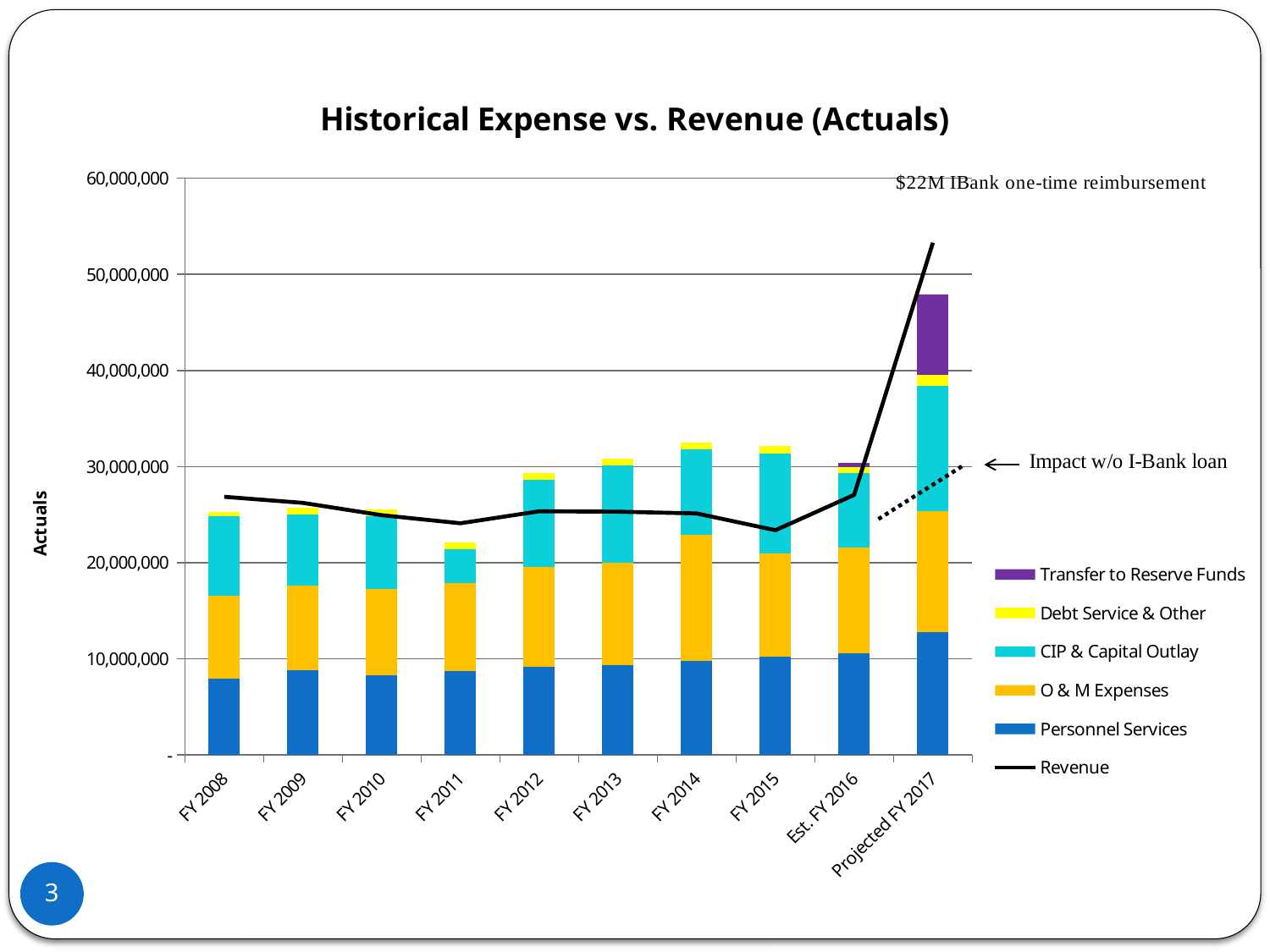
Which series is shown in purple at the top of the Projected FY 2017 bar? Transfer to Reserve Funds How many series does the legend list? 6 Is the Revenue value for Projected FY 2017 greater or less than 50,000,000? greater What kind of chart is shown on the slide? combination bar and line chart Which fiscal year has the tallest stacked expense bar? Projected FY 2017 Is the Personnel Services segment for FY 2008 greater or less than 10,000,000? less Which fiscal year has the shortest stacked expense bar? FY 2011 Which has the larger total expense bar, FY 2008 or FY 2014? FY 2014 Is the total expense bar for Projected FY 2017 greater or less than 40,000,000? greater Does the Revenue line rise or fall from Est. FY 2016 to Projected FY 2017? rises How many fiscal-year categories are shown on the x axis? 10